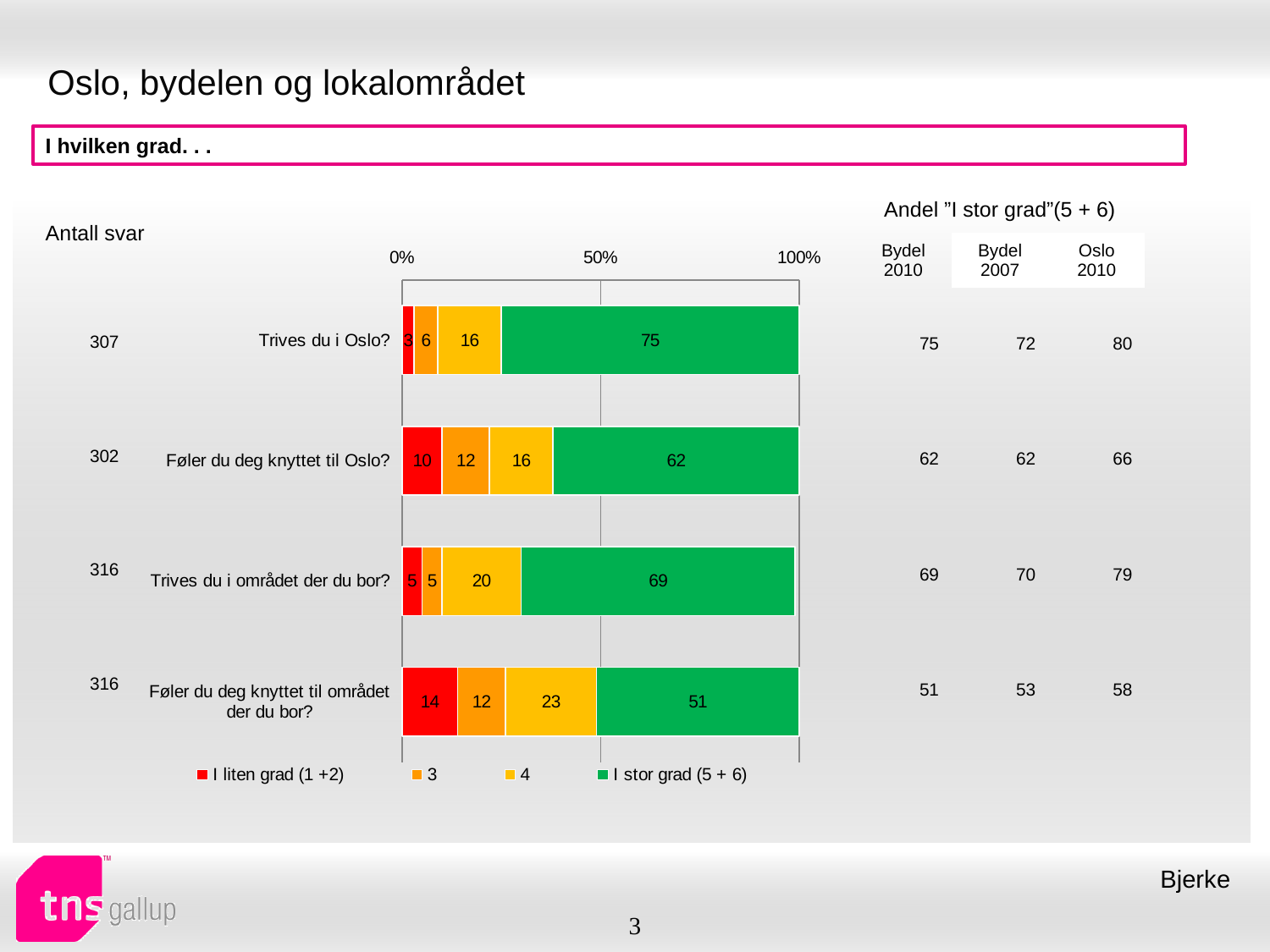
What is the difference between the 'I stor grad (5 + 6)' values for 'Trives du i Oslo?' and 'Føler du deg knyttet til Oslo?'? 13 What is the value of 'I liten grad (1 +2)' for 'Føler du deg knyttet til området der du bor?'? 14 What is the total of the stacked bar for 'Føler du deg knyttet til området der du bor?'? 100 What is the value of series '4' for 'Trives du i området der du bor?'? 20 What kind of chart is shown on the slide? stacked bar chart What is the value of series '3' for 'Føler du deg knyttet til Oslo?'? 12 Which category has the lowest 'I stor grad (5 + 6)' value? Føler du deg knyttet til området der du bor? Which category has the highest 'I stor grad (5 + 6)' value? Trives du i Oslo? How many question categories are plotted in the bar chart? 4 What is the value of 'I stor grad (5 + 6)' for 'Trives du i Oslo?'? 75 Which is larger: the 'I liten grad (1 +2)' value for 'Føler du deg knyttet til Oslo?' or for 'Trives du i området der du bor?'? Føler du deg knyttet til Oslo? How many series does the legend list? 4